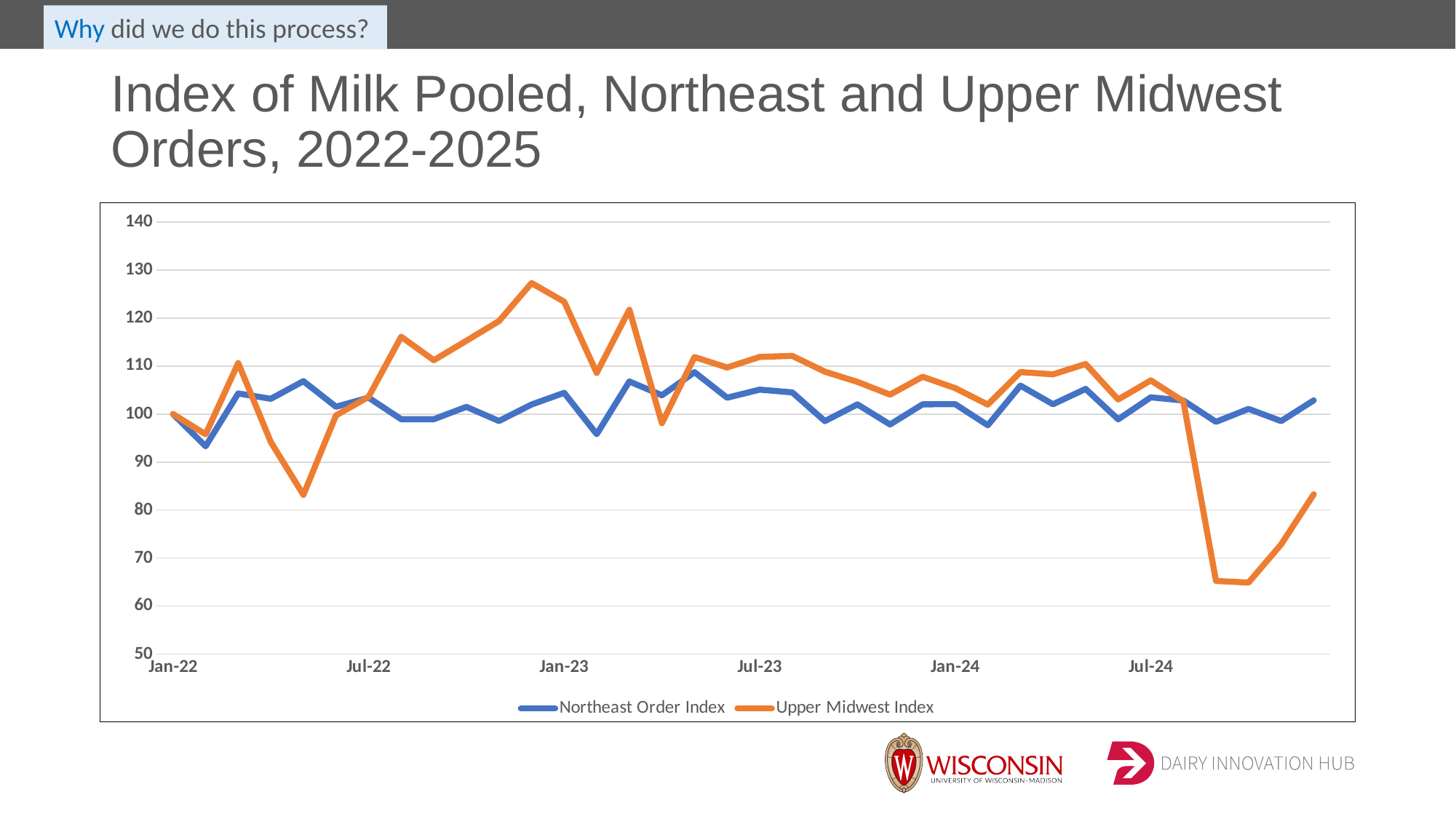
At Jan-23, which series has the higher value, Northeast Order Index or Upper Midwest Index? Upper Midwest Index Which series reaches the lowest value anywhere on the chart? Upper Midwest Index Is the lowest value reached by the Upper Midwest Index greater or less than 70? less What are the two series named in the legend? Northeast Order Index and Upper Midwest Index Which series reaches the highest value anywhere on the chart? Upper Midwest Index How many series does the legend list? 2 Is the value of the Northeast Order Index at Jul-23 greater or less than 100? greater How many date labels are shown on the x axis? 6 What kind of chart is shown on the slide? line chart Is the value of the Upper Midwest Index at Jul-23 greater or less than 110? greater What colour is the line for the Upper Midwest Index? orange